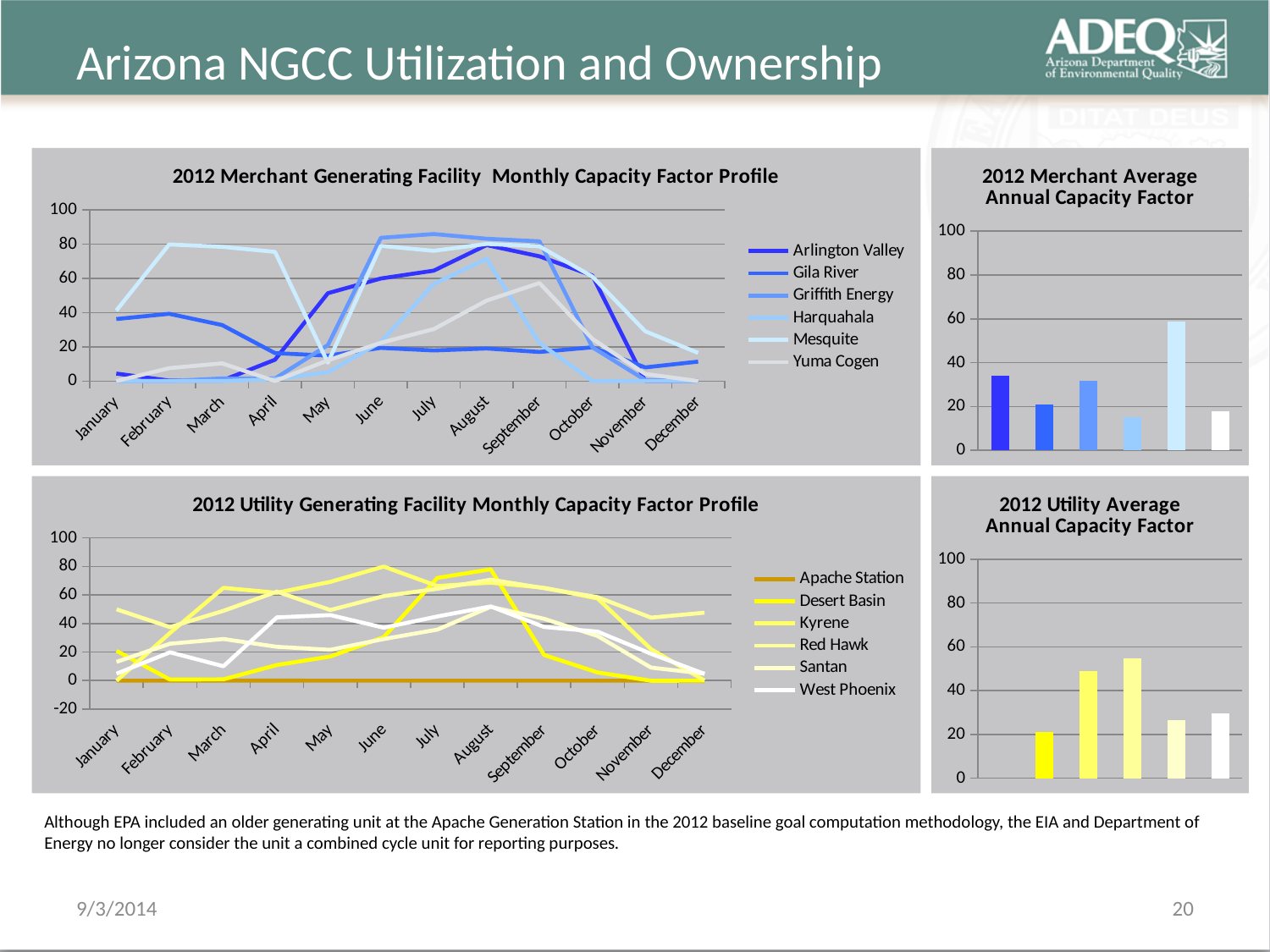
In the '2012 Utility Generating Facility Monthly Capacity Factor Profile' chart, is the value for Desert Basin in August greater or less than 60? greater In the '2012 Utility Generating Facility Monthly Capacity Factor Profile' chart, is the value for Apache Station in June greater or less than 20? less How many series does the legend of the '2012 Utility Generating Facility Monthly Capacity Factor Profile' chart list? 6 In the '2012 Merchant Generating Facility Monthly Capacity Factor Profile' chart, is the value for Mesquite in February greater or less than 60? greater How many bars are in the '2012 Utility Average Annual Capacity Factor' chart? 5 How many bars are in the '2012 Merchant Average Annual Capacity Factor' chart? 6 What kind of chart is the '2012 Merchant Generating Facility Monthly Capacity Factor Profile'? line chart How many months are shown on the x axis of the '2012 Utility Generating Facility Monthly Capacity Factor Profile' chart? 12 What kind of chart is the '2012 Utility Average Annual Capacity Factor'? bar chart How many series does the legend of the '2012 Merchant Generating Facility Monthly Capacity Factor Profile' chart list? 6